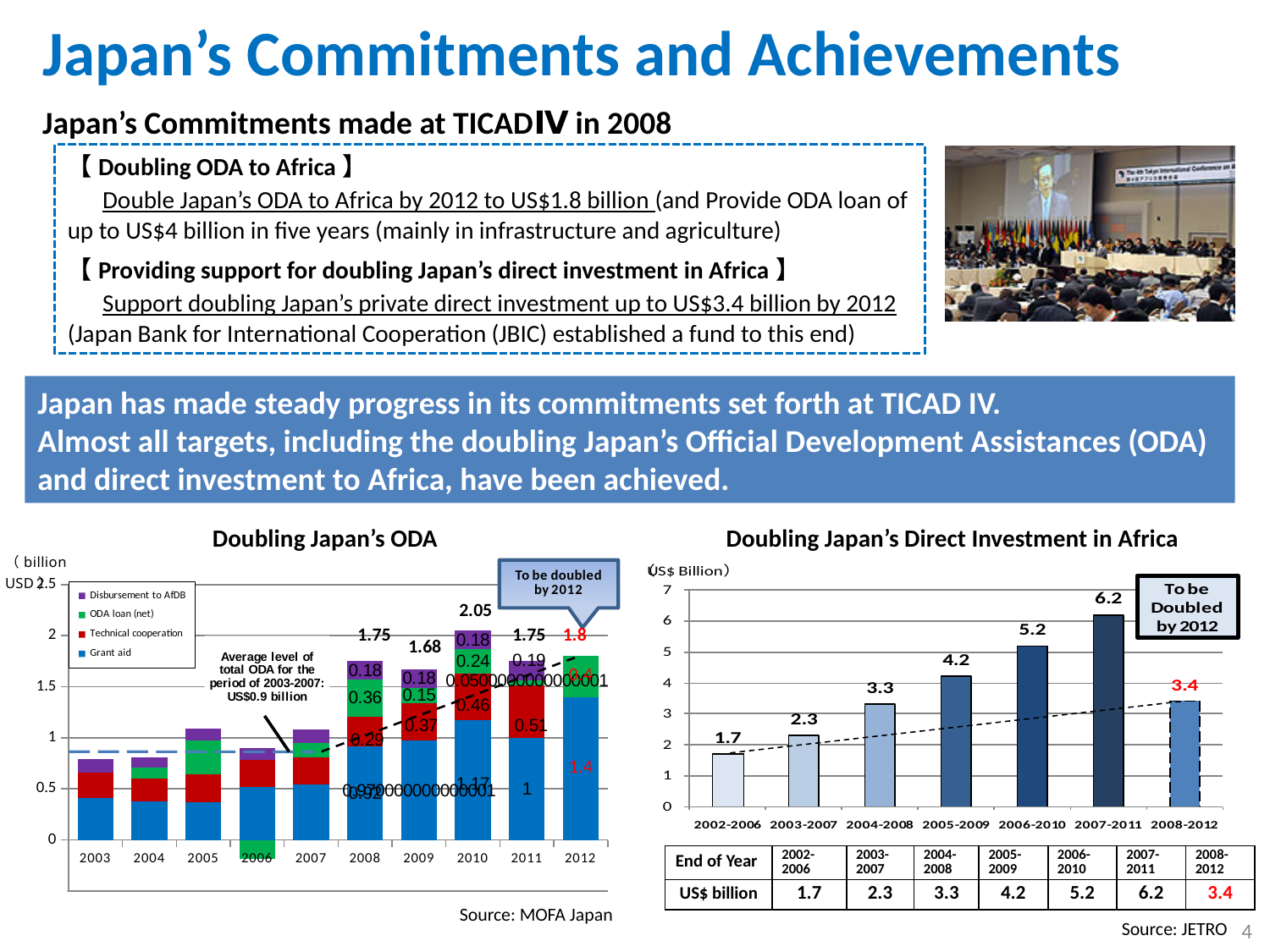
In the 'Doubling Japan's Direct Investment in Africa' chart, what is the difference between the values for 2007-2011 and 2002-2006? 4.5 How many series does the legend of the 'Doubling Japan's ODA' chart list? 4 In the 'Doubling Japan's Direct Investment in Africa' chart, which period has the lowest value? 2002-2006 In the 'Doubling Japan's Direct Investment in Africa' chart, what is the value for 2007-2011? 6.2 In the 'Doubling Japan's ODA' chart, what is the total ODA value labeled for 2010? 2.05 What type of chart is 'Doubling Japan's Direct Investment in Africa'? Bar chart In the 'Doubling Japan's Direct Investment in Africa' chart, which is larger: the value for 2006-2010 or the value for 2008-2012? 2006-2010 How many bars are plotted in the 'Doubling Japan's Direct Investment in Africa' chart? 7 In the 'Doubling Japan's ODA' chart, is the total value for 2005 greater or less than 1.5? less In the 'Doubling Japan's Direct Investment in Africa' chart, which period has the highest value? 2007-2011 How many years are shown on the x axis of the 'Doubling Japan's ODA' chart? 10 In the 'Doubling Japan's Direct Investment in Africa' chart, what is the value for 2002-2006? 1.7